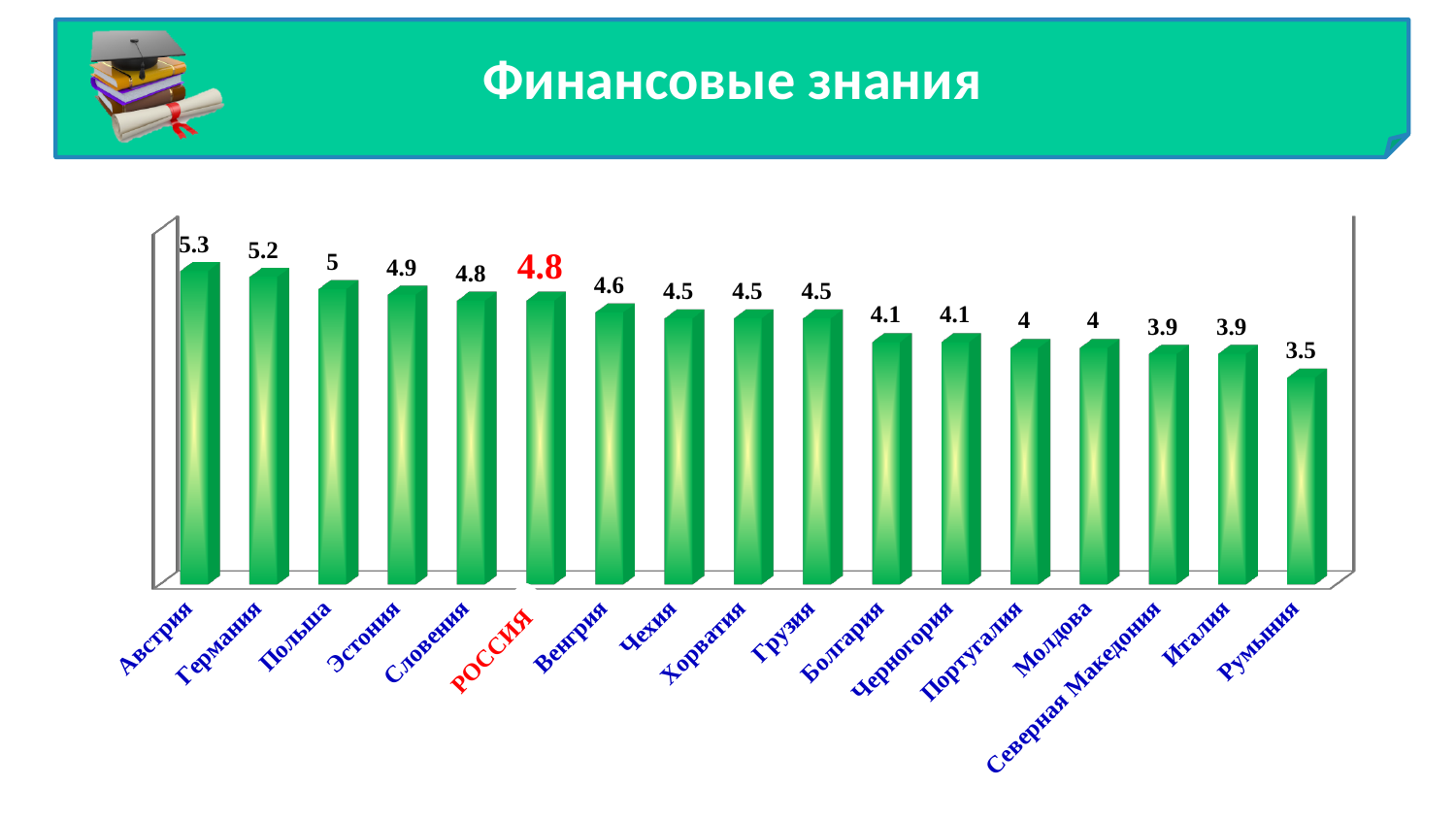
What is the value for РОССИЯ? 4.8 What kind of chart is shown on the slide? Bar chart What is the difference between the values for Германия and РОССИЯ? 0.4 What is the value for Румыния? 3.5 What is the value for Венгрия? 4.6 What is the difference between the values for Австрия and Румыния? 1.8 Which country has the lowest value? Румыния Which has a larger value, Польша or Болгария? Польша What is the title of the slide? Финансовые знания What is the value for Австрия? 5.3 Which country has the highest value? Австрия How many countries are shown in the chart? 17